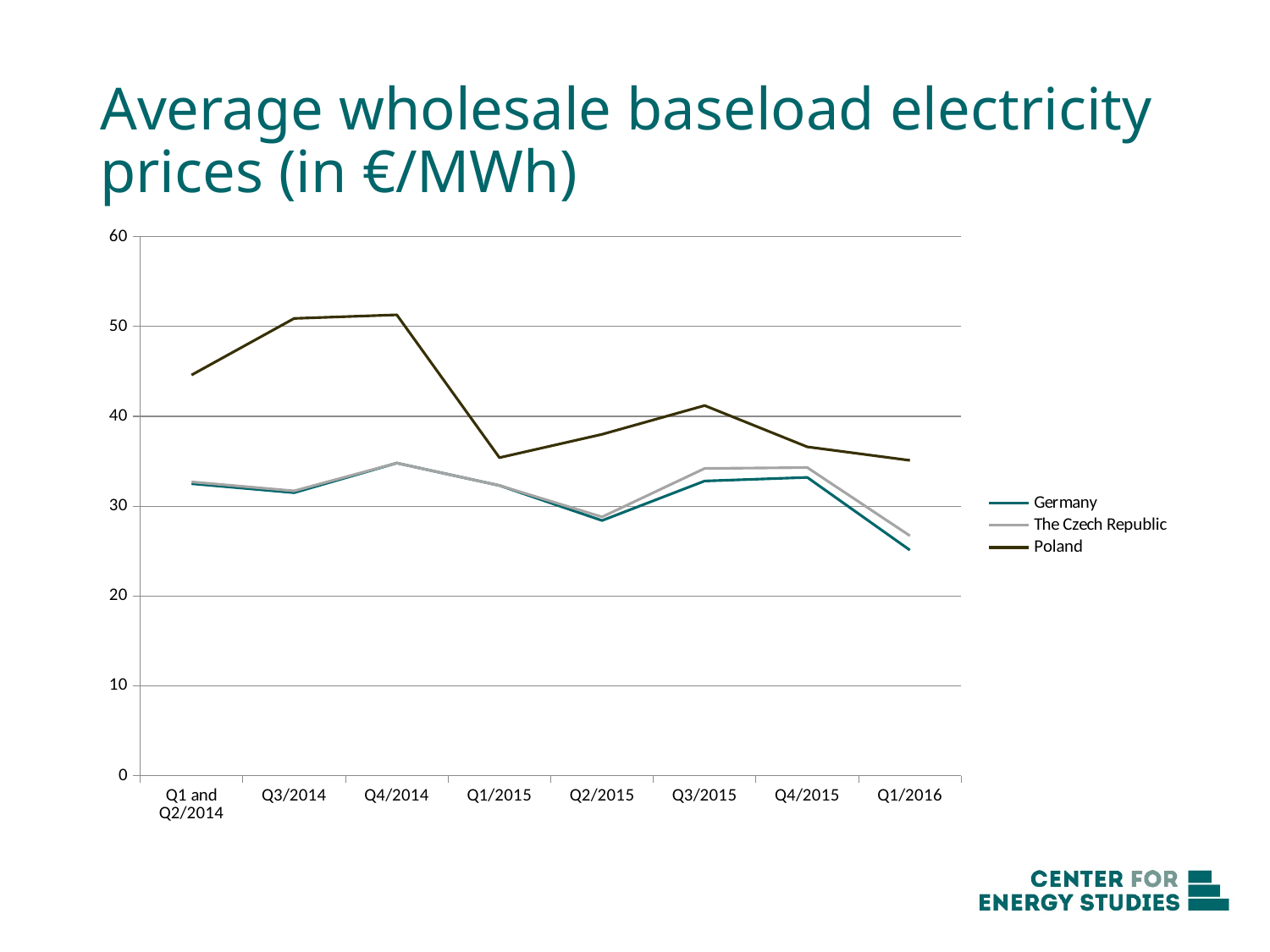
Is the value for Germany in Q1/2016 greater or less than 30? less Does the value for Poland rise or fall from Q4/2014 to Q1/2015? fall Which series has the highest values across the whole chart? Poland In which period does Germany reach its lowest value? Q1/2016 Is the value for Poland in Q1/2015 greater or less than 40? less Is the value for Poland in Q4/2014 greater or less than 50? greater What kind of chart is shown on the slide? line chart What unit is given in the chart title for the prices? €/MWh Which is larger in Q3/2015, the value for Poland or the value for Germany? Poland In which period does Poland reach its highest value? Q4/2014 How many series does the legend list? 3 How many time periods are shown on the x axis? 8